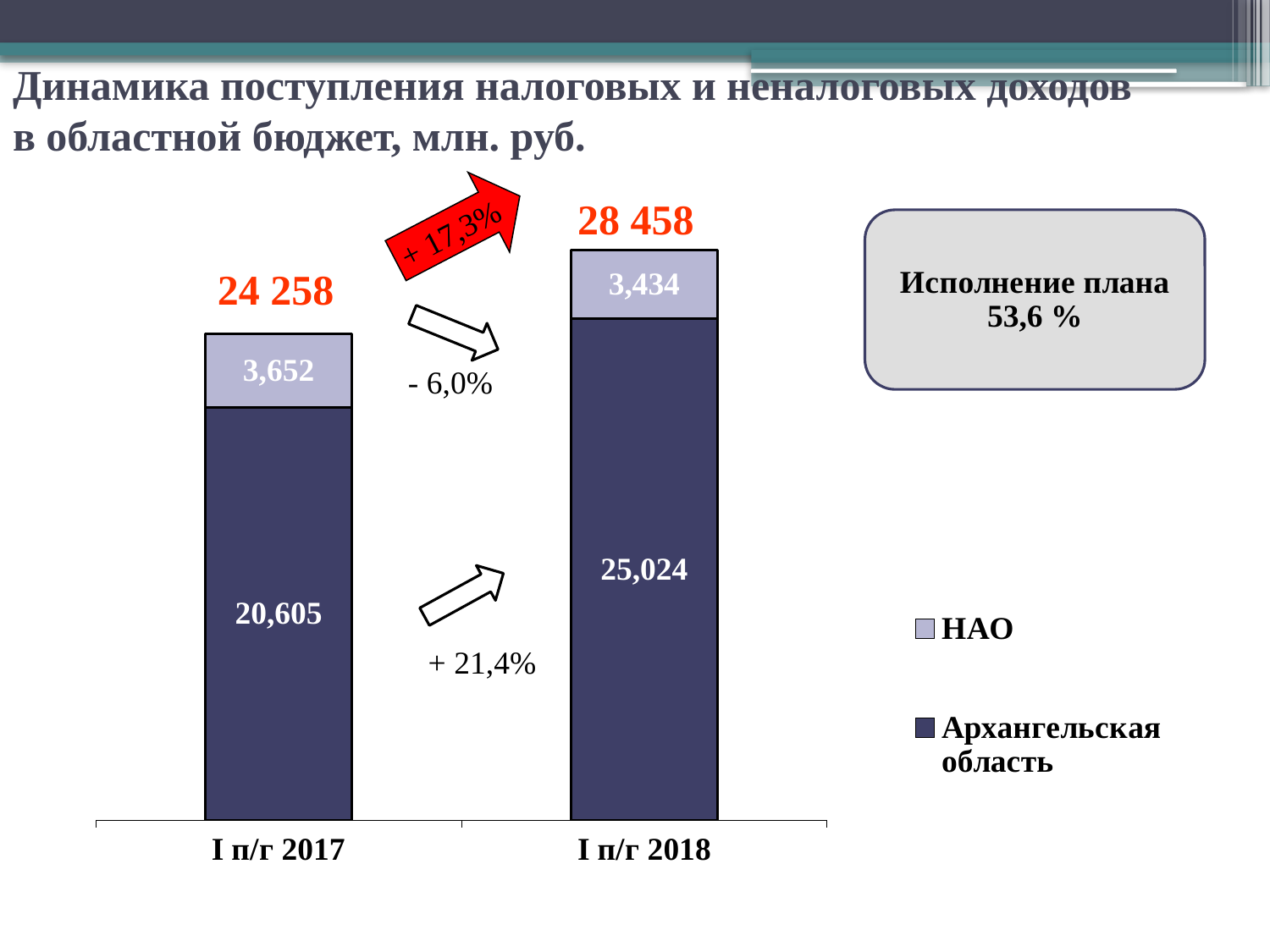
What is the value for НАО in I п/г 2017? 3,652 What is the value for Архангельская область in I п/г 2017? 20,605 What percentage change is shown by the red arrow between the two bars? + 17,3% What is the value for Архангельская область in I п/г 2018? 25,024 What is the total of the stacked bar for I п/г 2017? 24 258 How many series does the legend list? 2 What is the total of the stacked bar for I п/г 2018? 28 458 What is the value for НАО in I п/г 2018? 3,434 How many categories are shown on the x axis of the chart? 2 What type of chart is shown on the slide? Stacked bar chart Which is larger, the value for Архангельская область in I п/г 2017 or in I п/г 2018? I п/г 2018 What is the difference between the НАО values for I п/г 2017 and I п/г 2018? 0,218